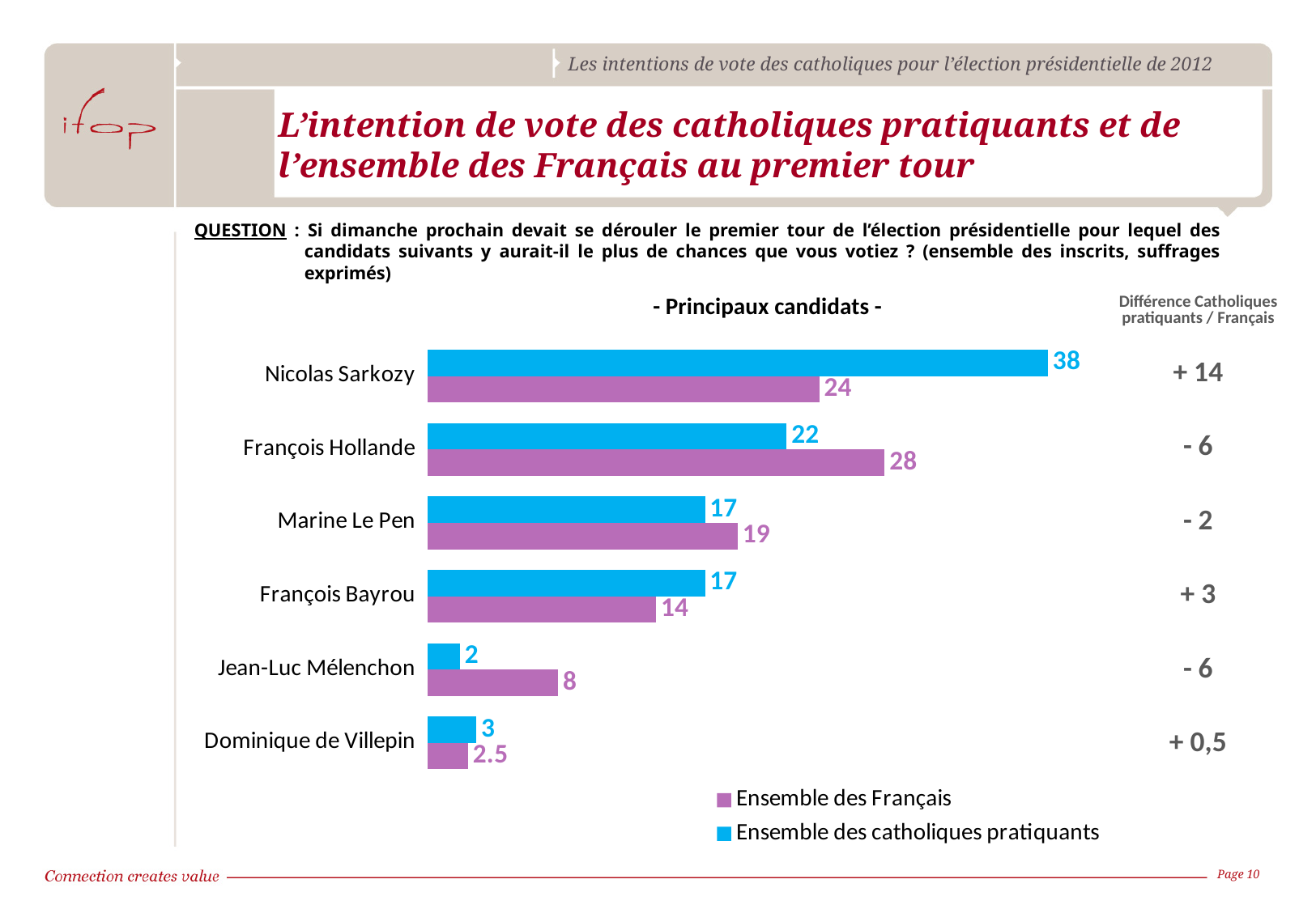
How many candidates are shown in the chart? 6 What is the value for Nicolas Sarkozy in the 'Ensemble des catholiques pratiquants' series? 38 How many series does the legend list? 2 What is the difference between the 'Ensemble des catholiques pratiquants' and 'Ensemble des Français' values for Jean-Luc Mélenchon? 6 What is the title shown above the chart? - Principaux candidats - For François Hollande, which series has the larger value: 'Ensemble des Français' or 'Ensemble des catholiques pratiquants'? Ensemble des Français Which candidate has the highest value in the 'Ensemble des catholiques pratiquants' series? Nicolas Sarkozy What is the value for Dominique de Villepin in the 'Ensemble des Français' series? 2.5 Which colour represents the 'Ensemble des Français' series? Purple Which candidate has the lowest value in the 'Ensemble des Français' series? Dominique de Villepin What is the value for François Hollande in the 'Ensemble des Français' series? 28 What kind of chart is shown on the slide? Bar chart